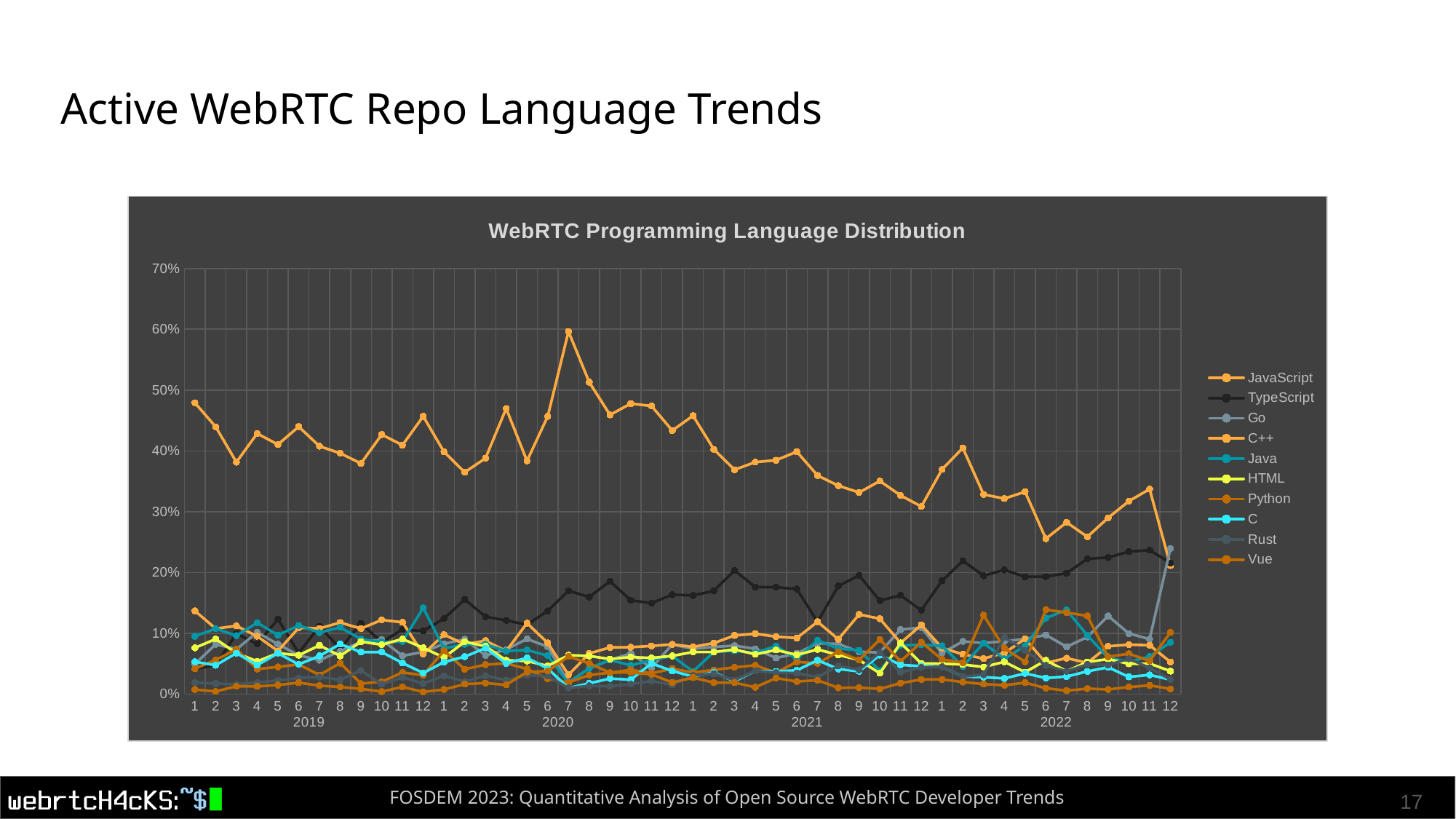
Is the value for JavaScript in July 2020 greater or less than 50%? greater Overall, does the JavaScript line rise or fall from 2019 to 2022? fall Is the value for JavaScript in January 2019 greater or less than 40%? greater Which programming language has the highest share for almost the entire period shown? JavaScript In January 2021, which is larger: the value for JavaScript or the value for TypeScript? JavaScript What kind of chart is shown on the slide? line chart What is the title printed inside the chart area? WebRTC Programming Language Distribution Overall, does the TypeScript line rise or fall from 2019 to 2022? rise How many series does the legend of the chart list? 10 Is the value for JavaScript in June 2022 greater or less than 30%? less